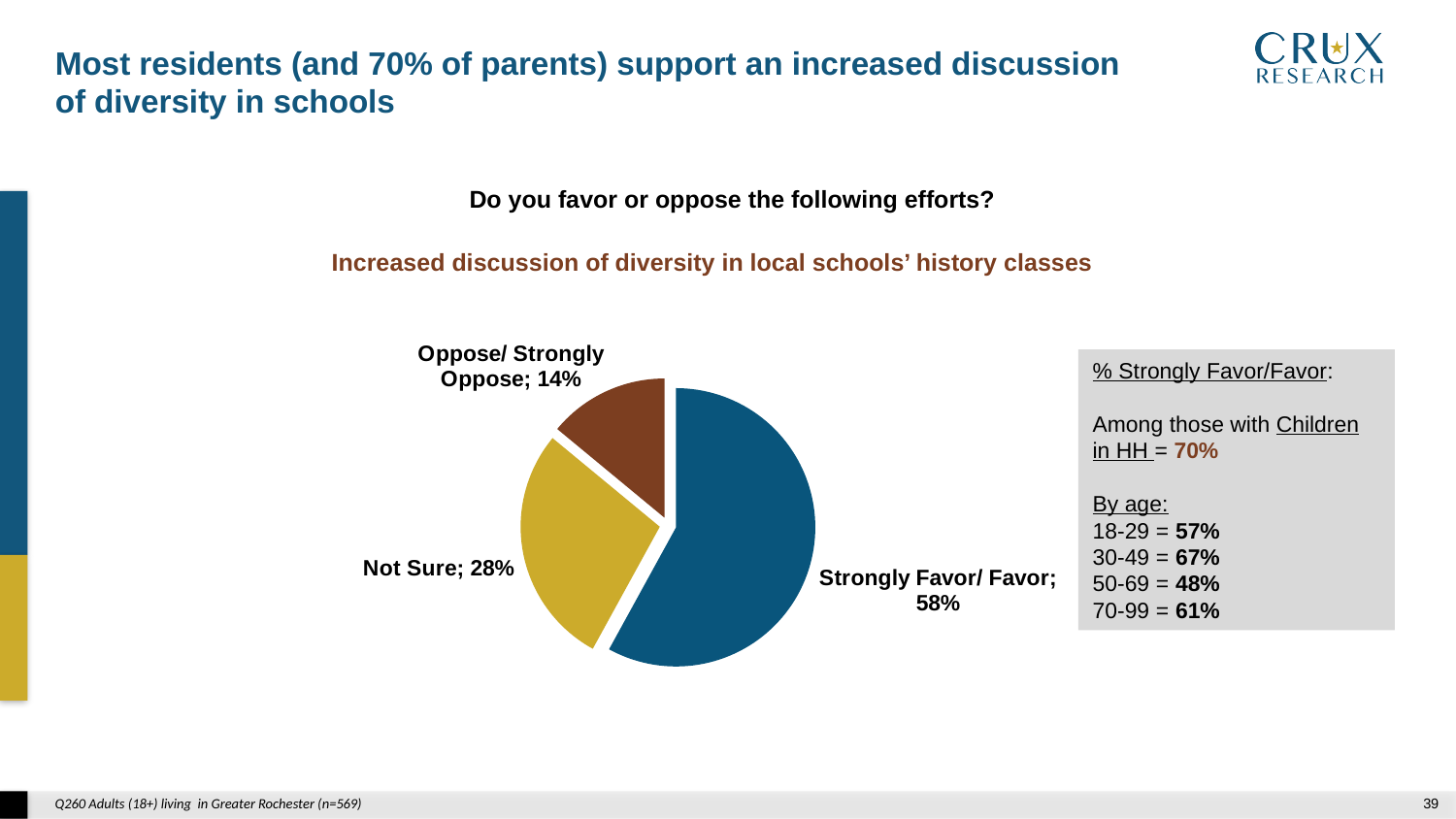
What percentage of respondents answered Oppose/Strongly Oppose? 14% Which is larger, the share for Not Sure or the share for Oppose/Strongly Oppose? Not Sure What percentage of respondents answered Strongly Favor/Favor? 58% How many slices does the pie chart have? 3 What is the difference in percentage points between Not Sure and Oppose/Strongly Oppose? 14 percentage points What effort is the pie chart about, according to the subtitle above it? Increased discussion of diversity in local schools' history classes What colour is the Strongly Favor/Favor slice of the pie? Blue What percentage of respondents answered Not Sure? 28% What kind of chart is shown on the slide? Pie chart What is the difference in percentage points between Strongly Favor/Favor and Oppose/Strongly Oppose? 44 percentage points Which response category has the smallest share of the pie? Oppose/Strongly Oppose Which response category has the largest share of the pie? Strongly Favor/Favor